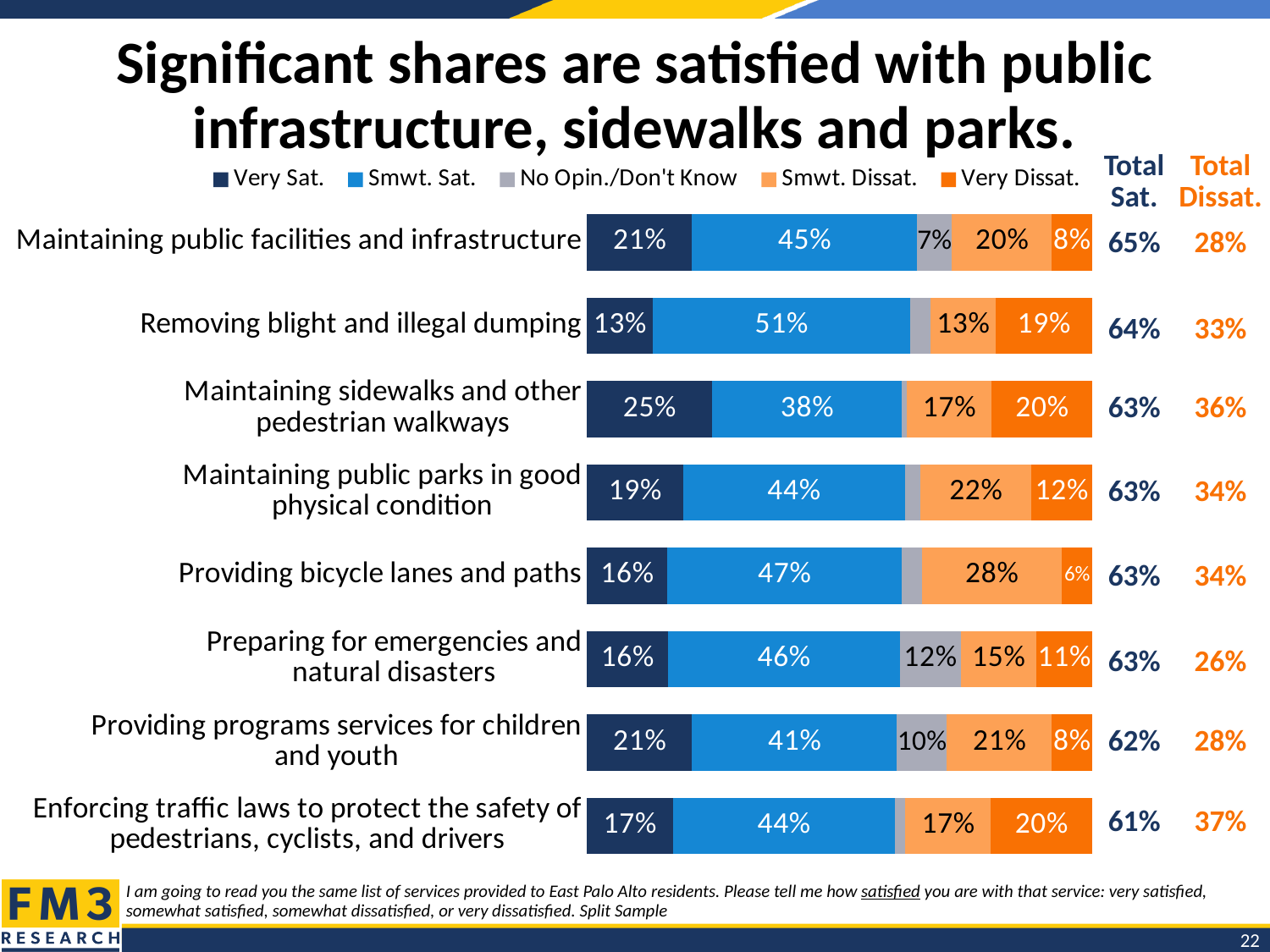
How many series does the legend list? 5 What is the No Opin./Don't Know value for "Preparing for emergencies and natural disasters"? 12% What is the Very Sat. value for "Maintaining sidewalks and other pedestrian walkways"? 25% What is the Smwt. Dissat. value for "Providing bicycle lanes and paths"? 28% How many service categories are plotted in the chart? 8 What kind of chart is shown on the slide? Stacked bar chart Which category has the lowest Total Sat. value? Enforcing traffic laws to protect the safety of pedestrians, cyclists, and drivers What is the Smwt. Sat. value for "Removing blight and illegal dumping"? 51% Which is larger: the Smwt. Sat. value for "Providing bicycle lanes and paths" or for "Maintaining public parks in good physical condition"? Providing bicycle lanes and paths What is the difference between the Very Sat. values for "Maintaining sidewalks and other pedestrian walkways" and "Removing blight and illegal dumping"? 12 percentage points Which category has the highest Very Sat. value? Maintaining sidewalks and other pedestrian walkways Which category has the highest Total Dissat. value? Enforcing traffic laws to protect the safety of pedestrians, cyclists, and drivers